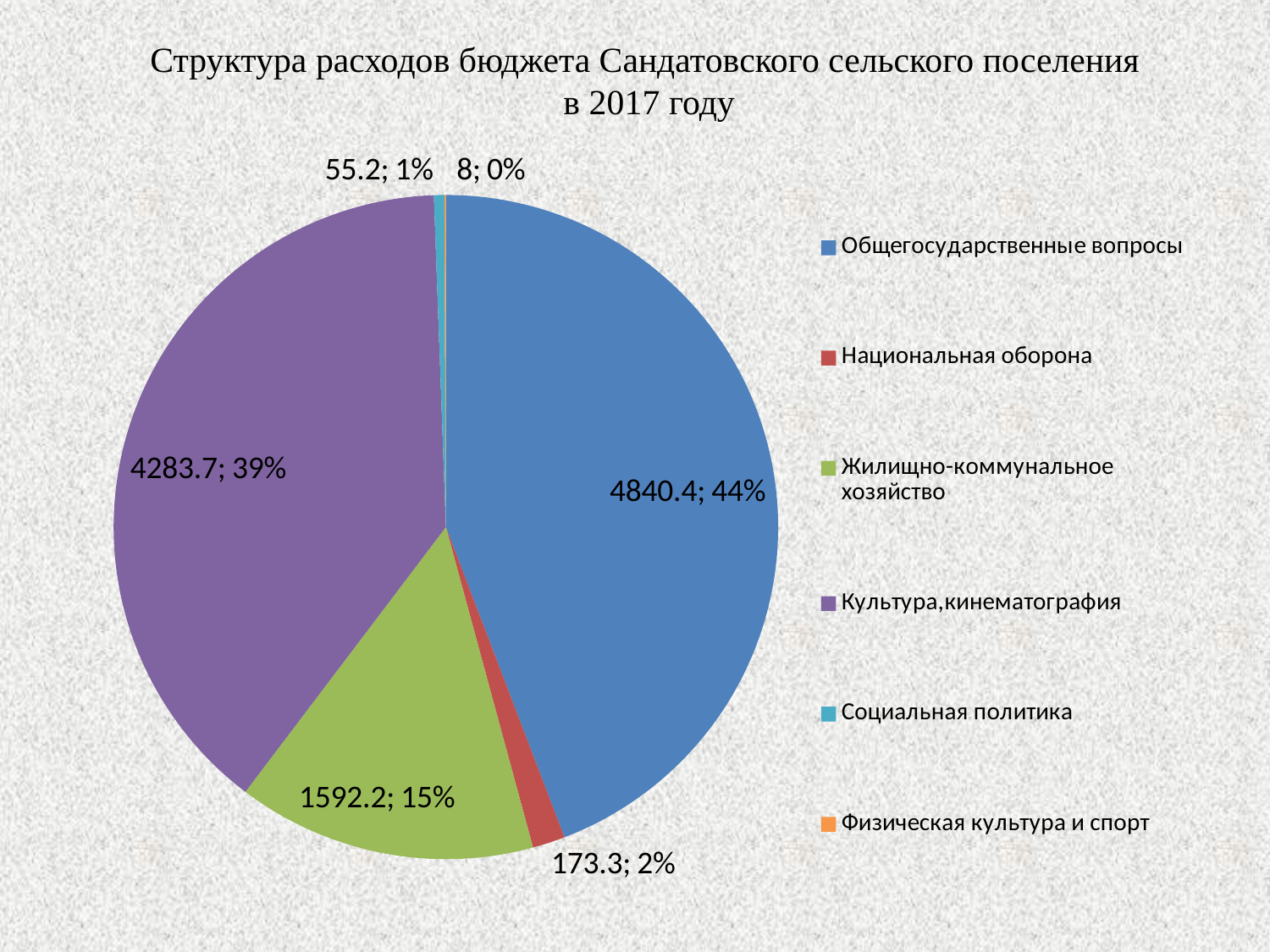
What is the value shown for Общегосударственные вопросы? 4840.4 What is the difference between the values for Общегосударственные вопросы and Культура,кинематография? 556.7 What is the value shown for Культура,кинематография? 4283.7 Which category has the largest slice of the pie? Общегосударственные вопросы What kind of chart is shown on the slide? pie chart What share of the pie does Культура,кинематография take? 39% What is the value shown for Национальная оборона? 173.3 How many categories does the legend list? 6 Which is larger, the value for Социальная политика or the value for Национальная оборона? Национальная оборона What is the value shown for Жилищно-коммунальное хозяйство? 1592.2 Which category has the smallest slice of the pie? Физическая культура и спорт What share of the pie does Жилищно-коммунальное хозяйство take? 15%